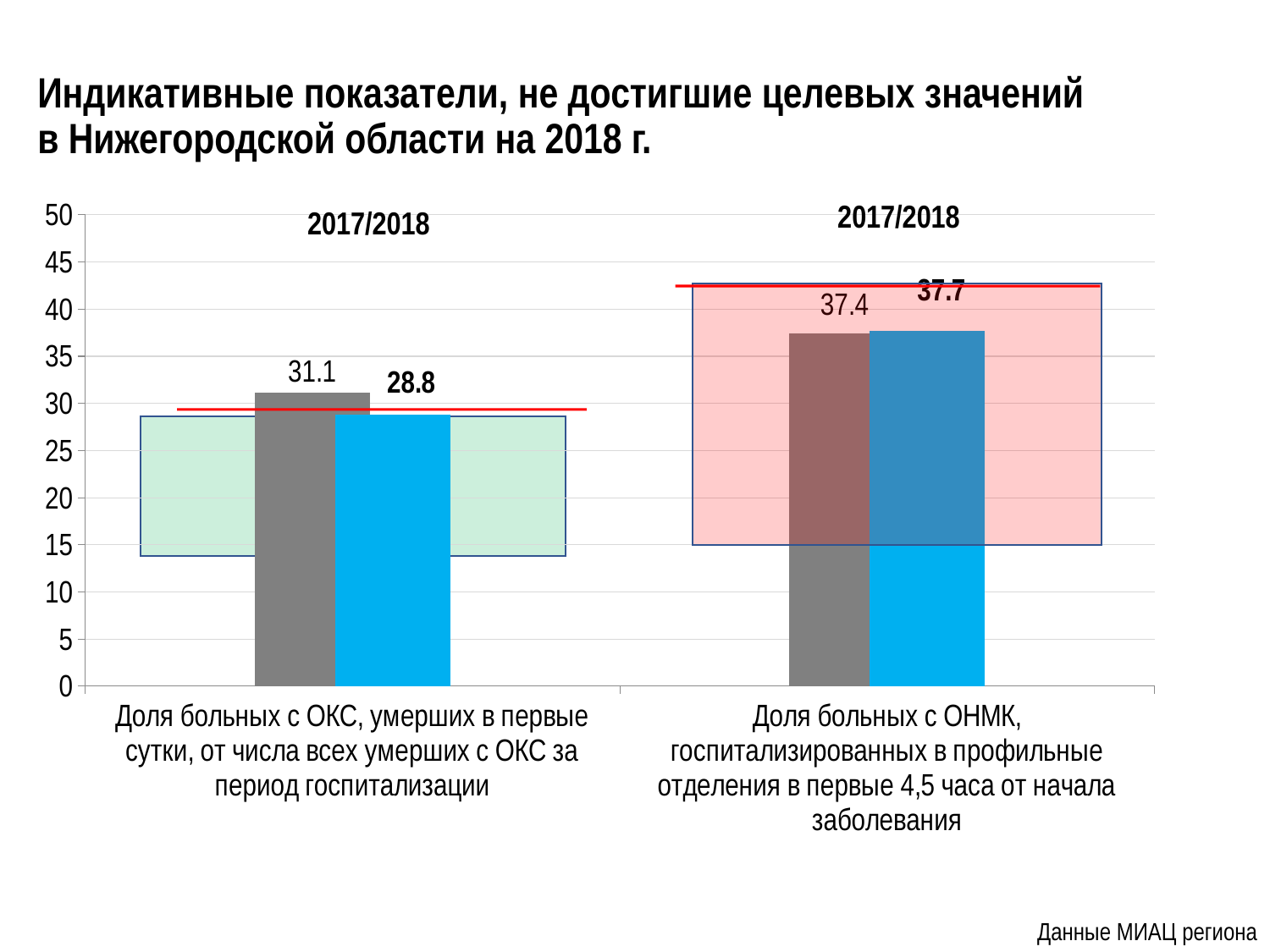
By how much did the value for 'Доля больных с ОКС, умерших в первые сутки...' change from 2017 to 2018? 2.3 What is the difference between the 2018 and 2017 values for 'Доля больных с ОНМК, госпитализированных в профильные отделения...'? 0.3 What kind of chart is shown on the slide? Bar chart For 'Доля больных с ОКС, умерших в первые сутки...', which year has the larger value, 2017 or 2018? 2017 Is the 2018 value for 'Доля больных с ОКС, умерших в первые сутки...' greater or less than 30? less What is the 2018 value for the category 'Доля больных с ОНМК, госпитализированных в профильные отделения...'? 37.7 What is the 2017 value for the category 'Доля больных с ОНМК, госпитализированных в профильные отделения...'? 37.4 What is the 2018 value for the category 'Доля больных с ОКС, умерших в первые сутки...'? 28.8 Which bar has the lowest labelled value on the chart? 2018, Доля больных с ОКС (28.8) How many categories are shown on the x axis of the chart? 2 What is the 2017 value for the category 'Доля больных с ОКС, умерших в первые сутки...'? 31.1 Which bar has the highest labelled value on the chart? 2018, Доля больных с ОНМК (37.7)